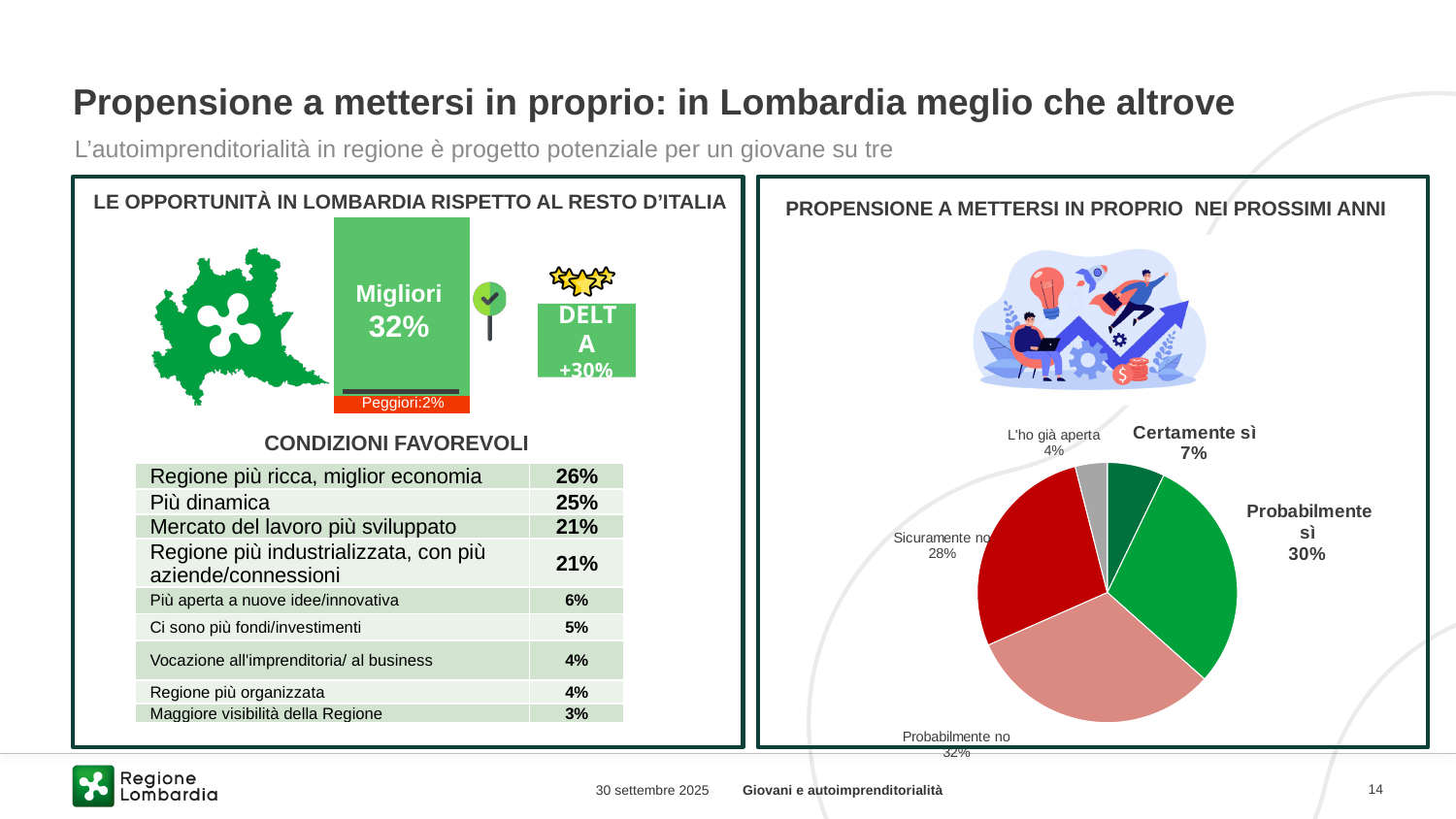
In the pie chart, what percentage is shown for 'L'ho già aperta'? 4% What kind of chart is shown under the title 'PROPENSIONE A METTERSI IN PROPRIO NEI PROSSIMI ANNI'? Pie chart In the pie chart, what is the combined percentage of 'Certamente sì' and 'Probabilmente sì'? 37% In the pie chart, which category has the largest slice? Probabilmente no In the pie chart, what is the difference in percentage points between 'Probabilmente no' and 'Sicuramente no'? 4 In the pie chart, which is larger: 'Probabilmente sì' or 'Sicuramente no'? Probabilmente sì In the pie chart, how many slices are there? 5 In the pie chart, which category has the smallest slice? L'ho già aperta In the pie chart, what percentage is shown for 'Certamente sì'? 7% What is the title of the pie chart on the right side of the slide? PROPENSIONE A METTERSI IN PROPRIO NEI PROSSIMI ANNI In the pie chart, what percentage is shown for 'Sicuramente no'? 28% In the pie chart, what percentage is shown for 'Probabilmente sì'? 30%